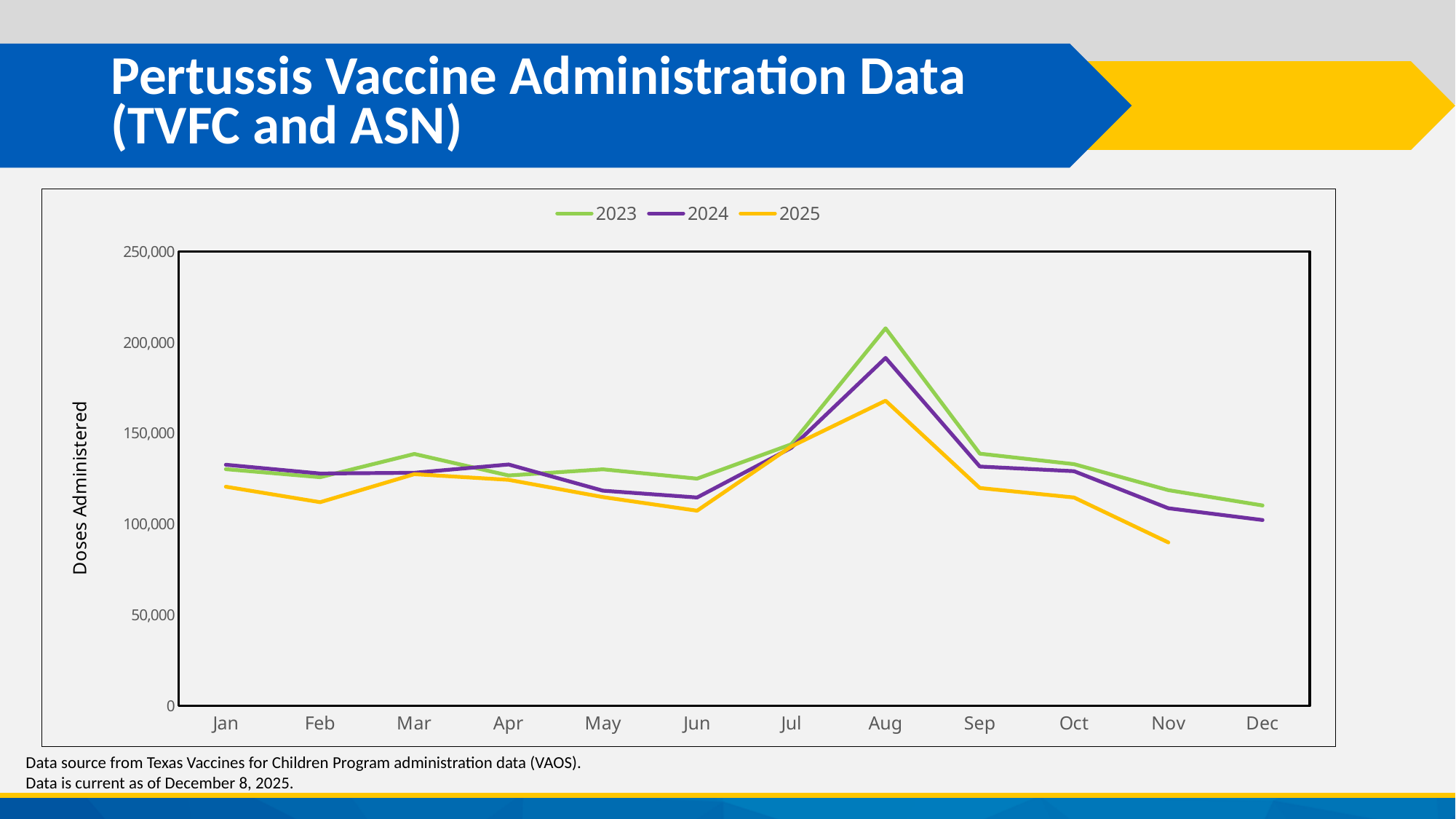
Do the 2025 values rise or fall from Aug to Nov? fall Is the value for 2025 in Aug greater or less than 150,000? greater How many series does the legend list? 3 In which month does the 2025 series reach its lowest value? Nov Is the value for 2023 in Aug greater or less than 200,000? greater Is the value for 2024 in Aug greater or less than 200,000? less In which month does the 2023 series reach its highest value? Aug What kind of chart is shown on the slide? line chart How many months are shown along the x axis? 12 Which series has the larger value in Aug, 2023 or 2024? 2023 What is the label on the y axis? Doses Administered